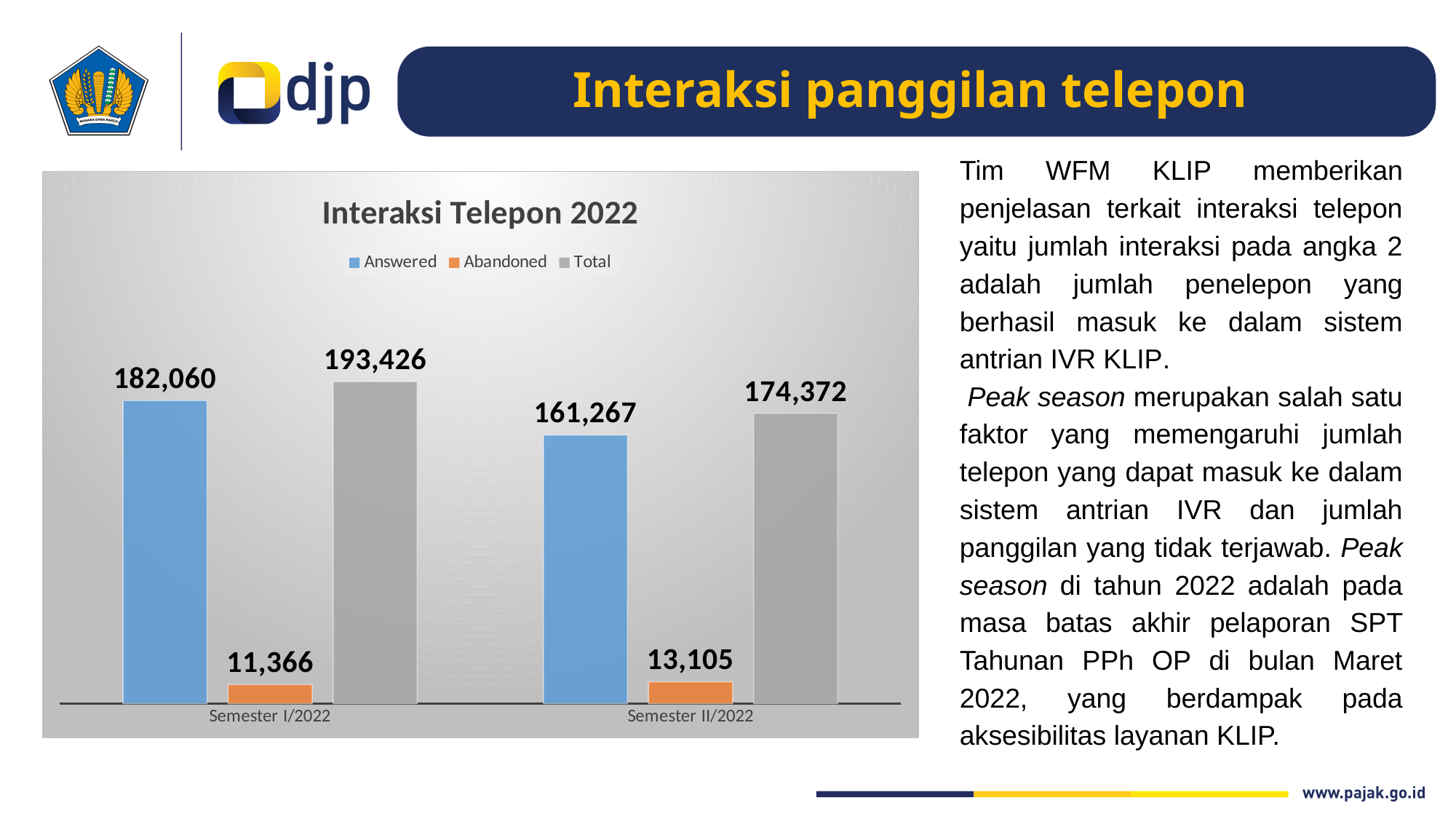
What kind of chart is shown on the slide? Bar chart Which semester has the lower Abandoned value? Semester I/2022 What is the Abandoned value for Semester II/2022? 13,105 What is the Answered value for Semester I/2022? 182,060 What is the Total value for Semester I/2022? 193,426 What is the title of the chart? Interaksi Telepon 2022 What is the difference between the Total values for Semester I/2022 and Semester II/2022? 19,054 How many series does the legend list? 3 What is the difference between the Answered values for Semester I/2022 and Semester II/2022? 20,793 Which semester has the higher Total value? Semester I/2022 What is the Answered value for Semester II/2022? 161,267 Is the Abandoned value larger in Semester I/2022 or Semester II/2022? Semester II/2022